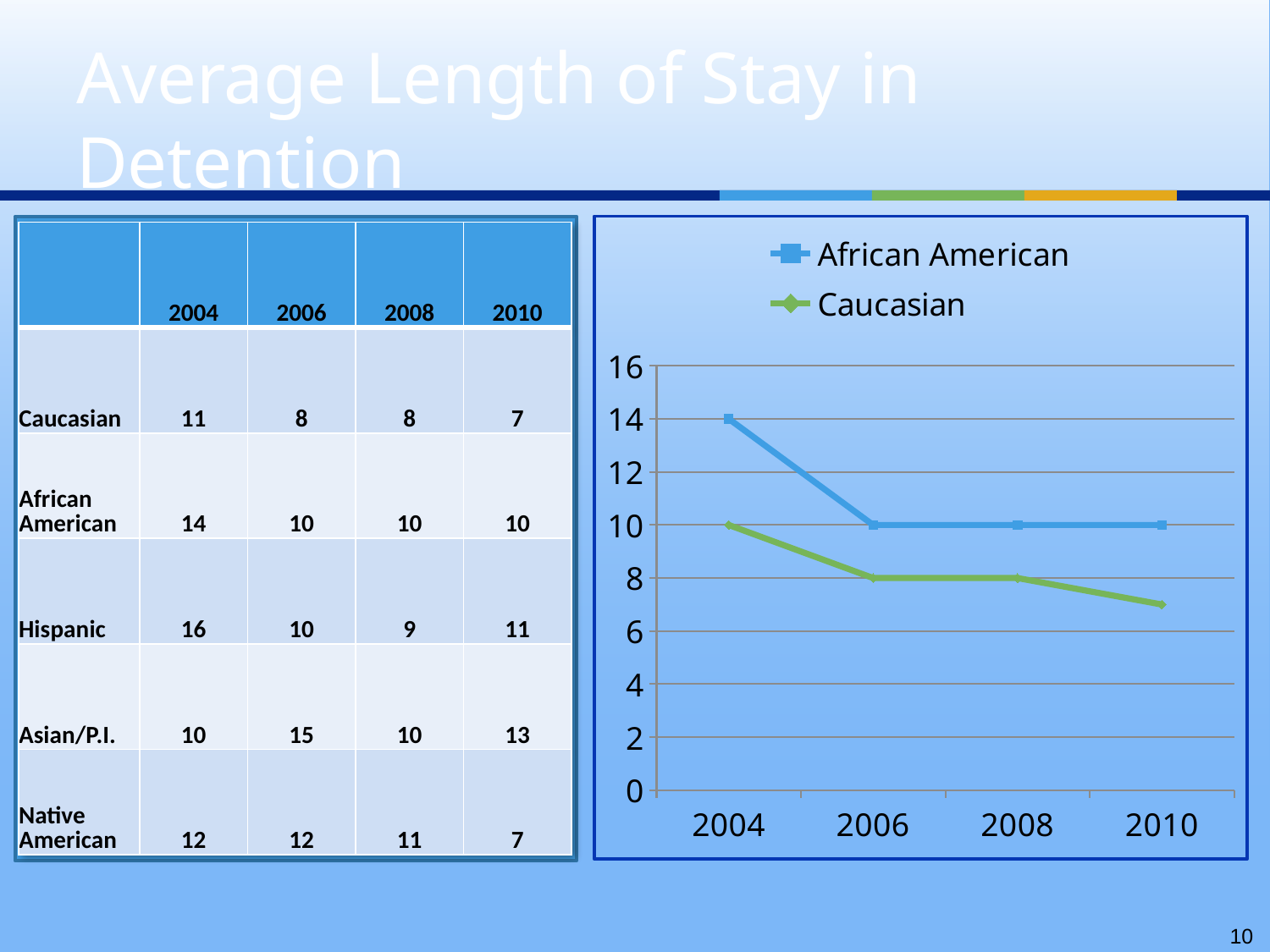
By how much did the African American value drop from 2004 to 2006 on the chart? 4 What is the value for African American in 2004 on the chart? 14 Does the Caucasian line rise or fall from 2004 to 2010 on the chart? fall What is the value for African American in 2010 on the chart? 10 In which year is the African American value highest on the chart? 2004 What is the value for Caucasian in 2010 on the chart? 7 What is the value for Caucasian in 2006 on the chart? 8 In 2008, which series has the larger value on the chart, African American or Caucasian? African American How many years are plotted along the x axis of the chart? 4 What kind of chart is shown on the right of the slide? line chart How many series does the chart's legend list? 2 In which year is the Caucasian value lowest on the chart? 2010